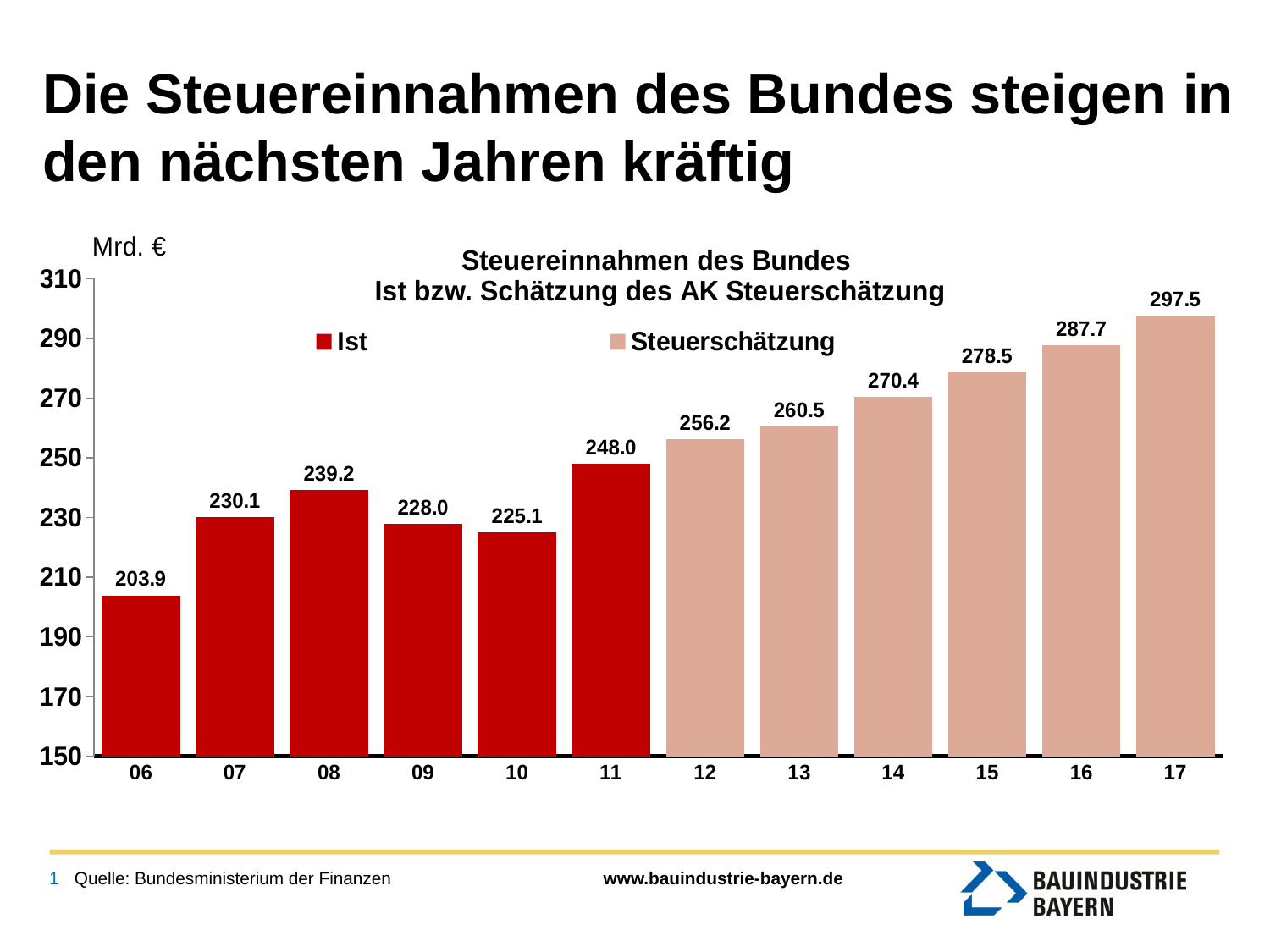
How many series does the legend list? 2 What kind of chart is shown? bar chart Which year has the lowest value? 06 What is the value for 2006 (06)? 203.9 Which is larger, the value for 08 or the value for 10? 08 What is the value for 2011 (11)? 248.0 Which year has the highest value? 17 How many years are shown on the x axis? 12 Is the value for 14 greater or less than 270? greater What is the difference between the values for 17 and 06? 93.6 What is the value for 2017 (17)? 297.5 What is the difference between the values for 08 and 09? 11.2